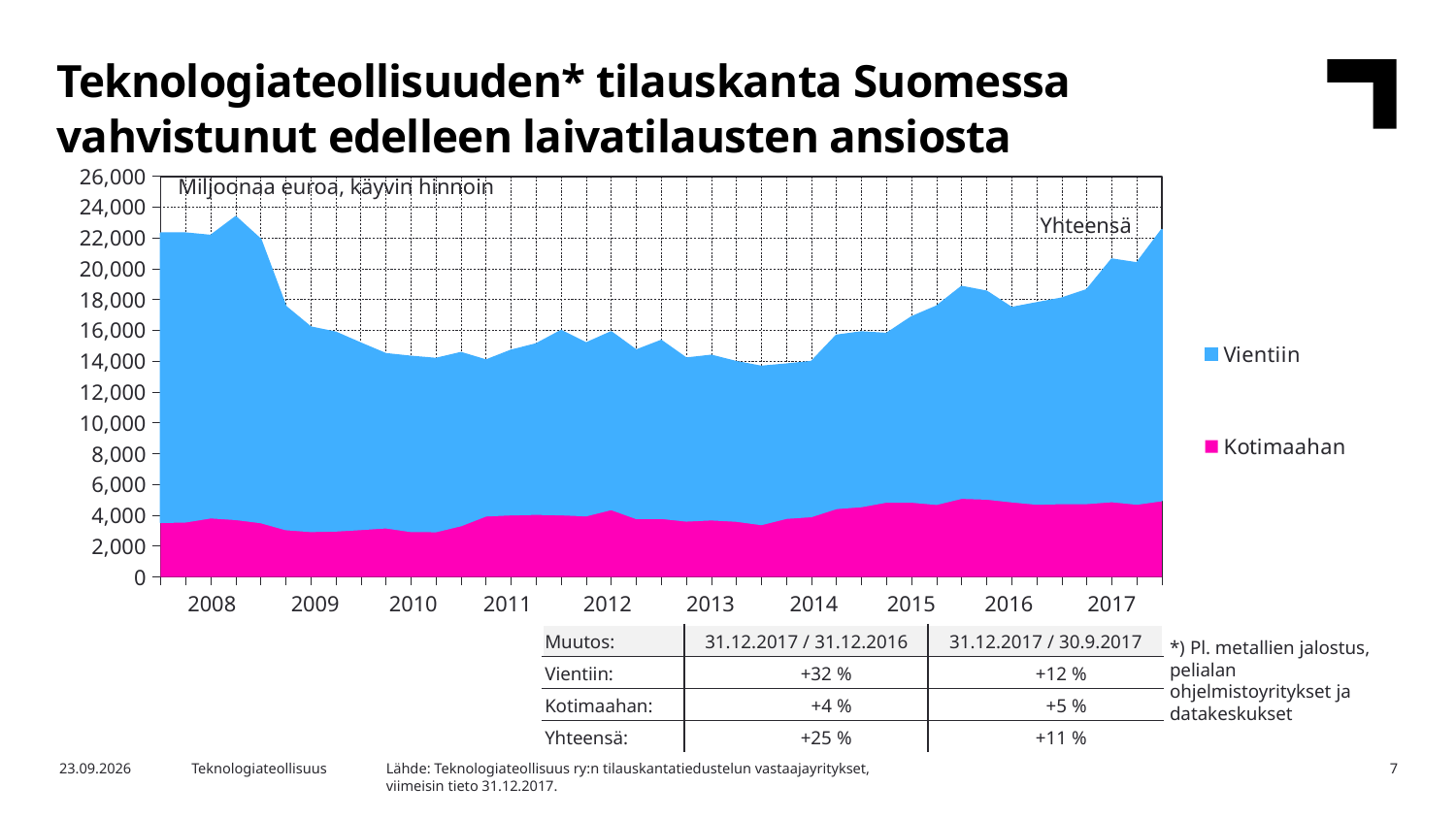
Is the total (Yhteensä) value at the end of 2017 greater or less than 20,000? greater How many year labels are shown on the x axis? 10 Does the total order book rise or fall between 2008 and 2010? fall Is the Kotimaahan value in 2009 greater or less than 4,000? less Which series is larger throughout the chart, Vientiin or Kotimaahan? Vientiin What are the two series named in the chart legend? Vientiin and Kotimaahan What unit label is printed inside the chart area? Miljoonaa euroa, käyvin hinnoin Does the total order book rise or fall between 2015 and the end of 2017? rise How many series does the chart legend list? 2 Is the peak total value in 2008 greater or less than 22,000? greater What kind of chart is shown on the slide? Stacked area chart